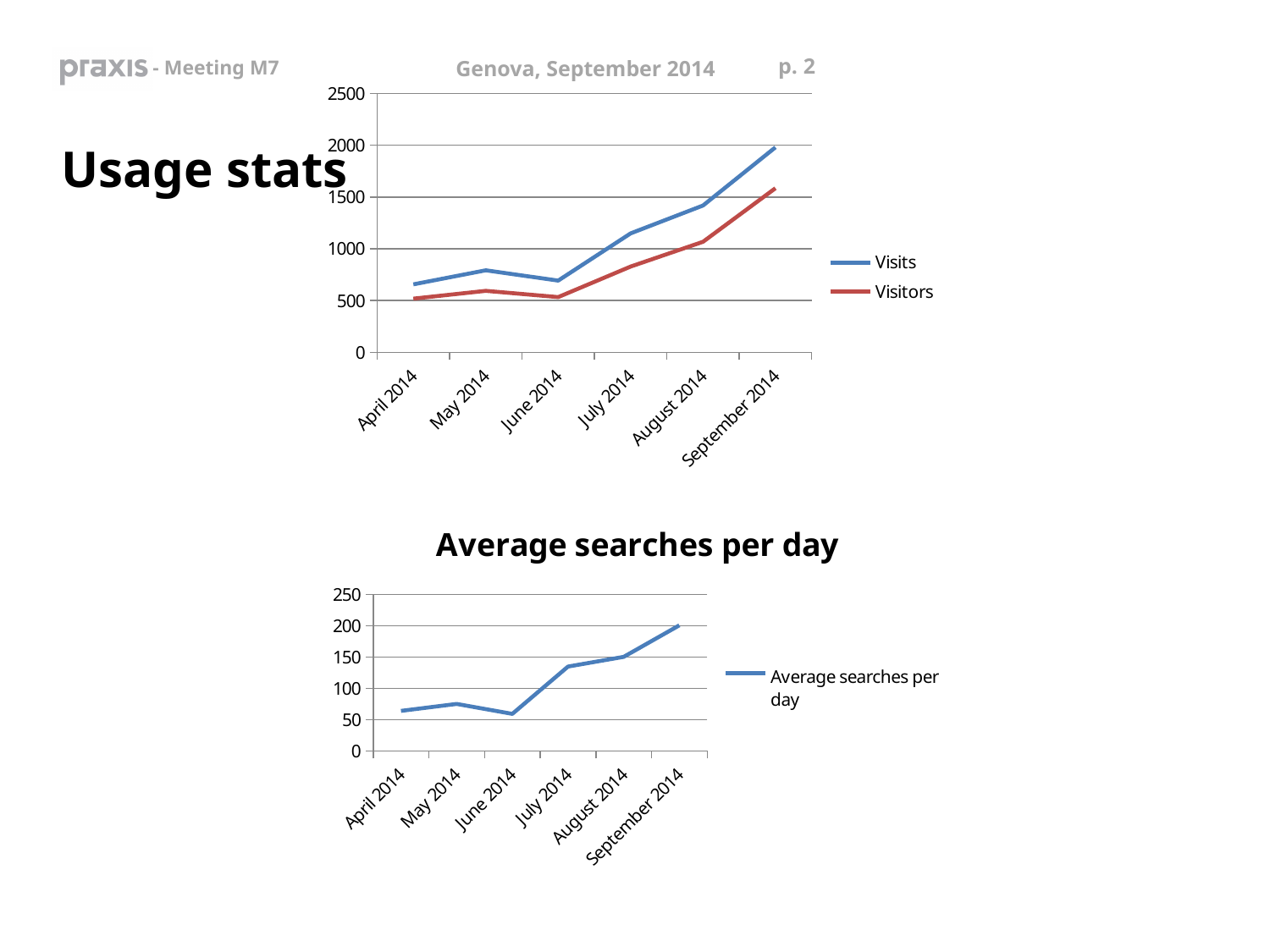
In the 'Average searches per day' chart, which month has the highest value? September 2014 In the top chart, is the value for Visitors in April 2014 greater or less than 1000? less In the top chart, which series is higher in August 2014, Visits or Visitors? Visits In the top chart, which month has the highest number of Visits? September 2014 In the top chart, is the value for Visits in September 2014 greater or less than 1500? greater How many series does the legend of the top chart list? 2 In the 'Average searches per day' chart, is the value for July 2014 greater or less than 100? greater In the 'Average searches per day' chart, do the values rise or fall from June 2014 to September 2014? rise What kind of chart is the 'Average searches per day' chart? line chart How many months are shown on the x axis of the top chart? 6 What kind of chart is the top chart on the slide (the one with Visits and Visitors)? line chart What is the legend entry shown in the 'Average searches per day' chart? Average searches per day